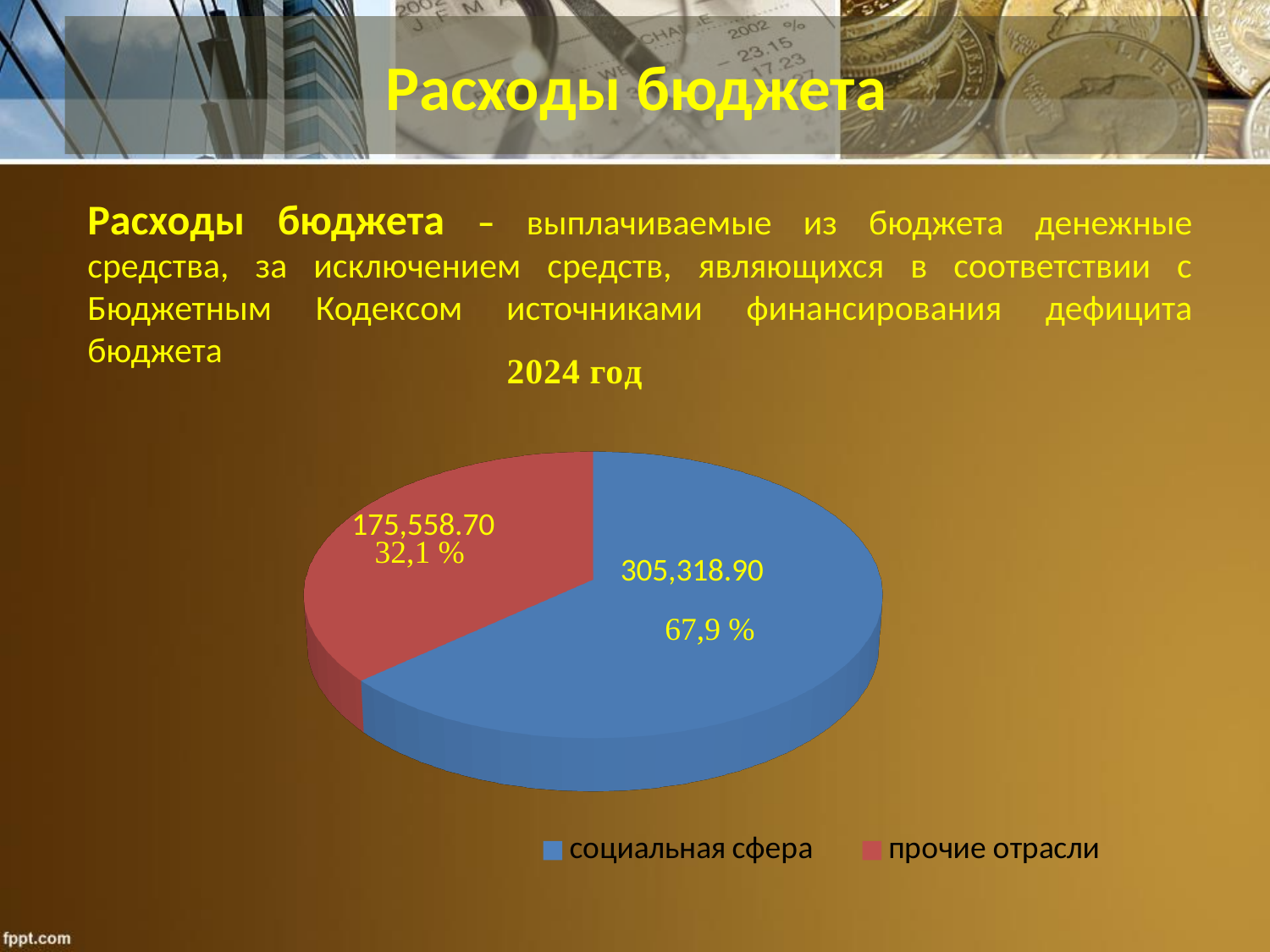
What is the value for социальная сфера in the pie chart? 305,318.90 What share of the pie does прочие отрасли represent? 32,1 % What is the difference between the values for социальная сфера and прочие отрасли? 129,760.20 What share of the pie does социальная сфера represent? 67,9 % What is the value for прочие отрасли in the pie chart? 175,558.70 What is the title of the pie chart? 2024 год Which category has the smallest slice in the pie chart? прочие отрасли Which is larger, социальная сфера or прочие отрасли? социальная сфера What is the total of the two values shown in the pie chart? 480,877.60 How many categories does the pie chart have? 2 Which category has the largest slice in the pie chart? социальная сфера What kind of chart is shown on the slide? pie chart